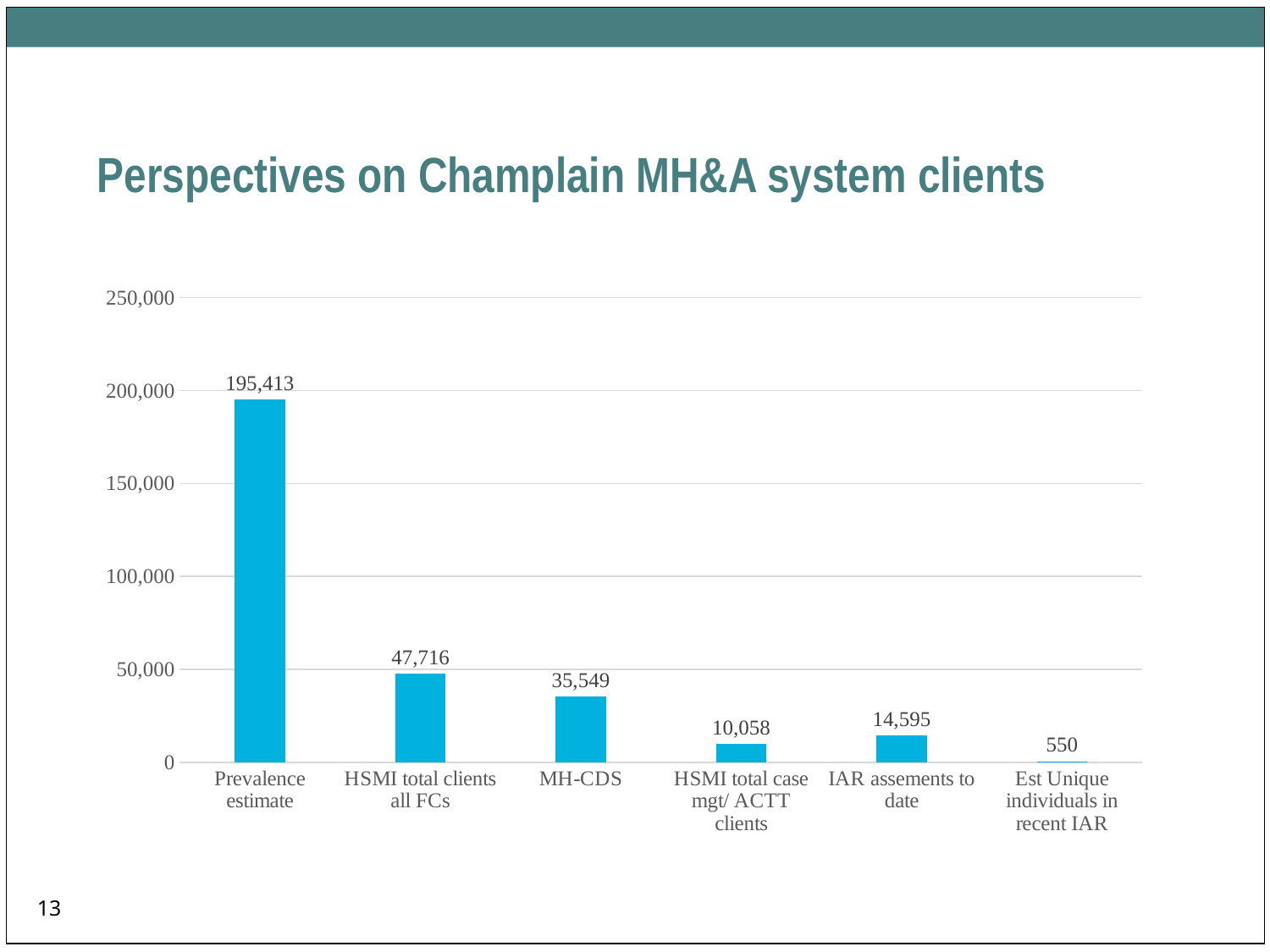
What is the difference between HSMI total clients all FCs and MH-CDS? 12,167 What kind of chart is shown on the slide? bar chart What is the value for MH-CDS? 35,549 What is the title of the slide? Perspectives on Champlain MH&A system clients What is the value for HSMI total clients all FCs? 47,716 What is the value for Prevalence estimate? 195,413 What is the value for IAR assesments to date? 14,595 Which category has the lowest value? Est Unique individuals in recent IAR Which category has the highest value? Prevalence estimate Which is larger, IAR assesments to date or HSMI total case mgt/ ACTT clients? IAR assesments to date How many categories are shown on the x axis? 6 Is the value for Prevalence estimate greater or less than 150,000? greater